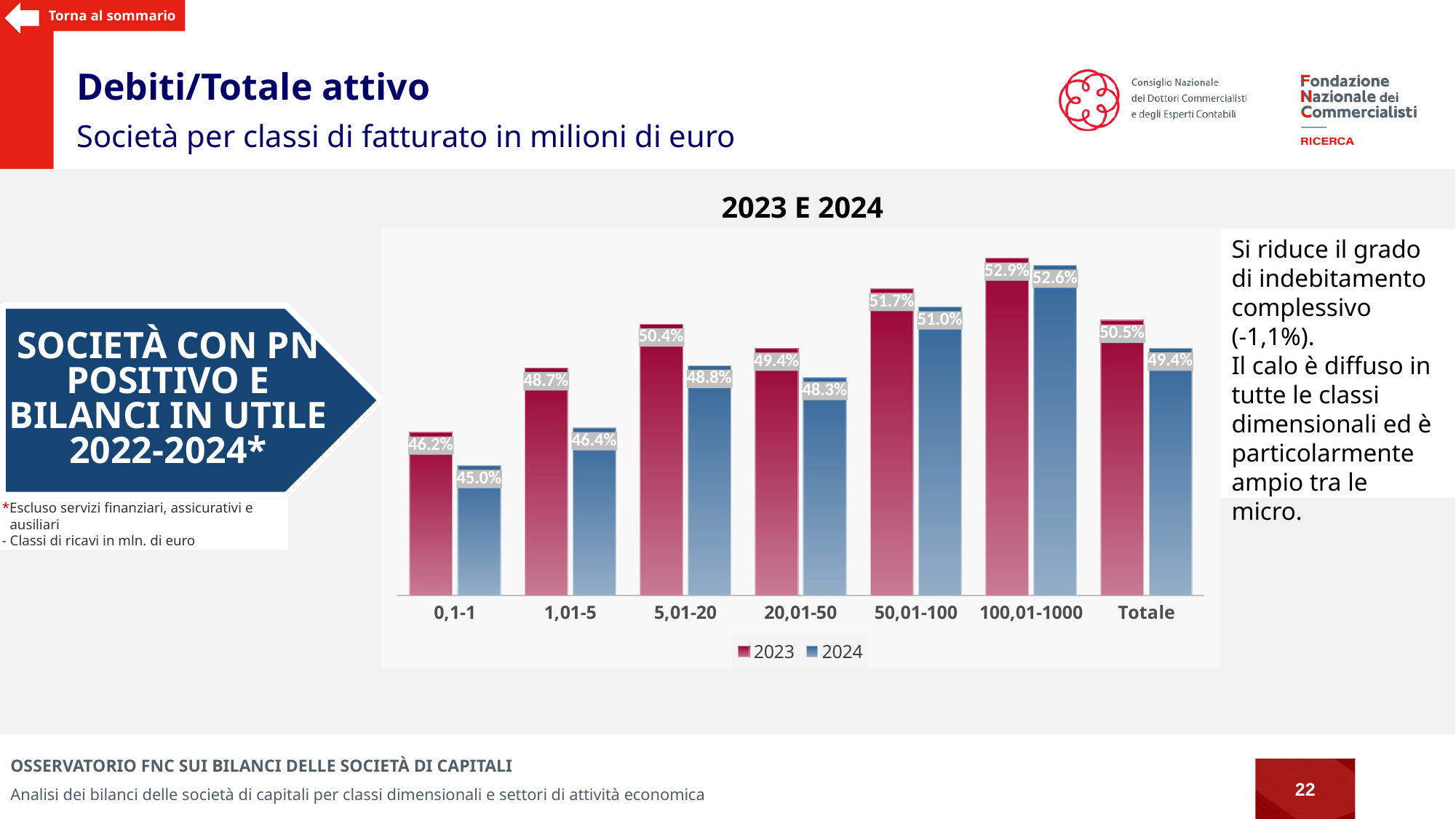
What is the difference between the 2023 and 2024 values for Totale? 1.1% How many series does the legend list? 2 Which class has the highest 2023 value? 100,01-1000 Which class has the lowest 2024 value? 0,1-1 What is the 2024 value for Totale? 49.4% What is the title of the chart? 2023 E 2024 What is the difference between the 2023 and 2024 values for the 1,01-5 class? 2.3% What is the 2023 value for the 0,1-1 class? 46.2% What is the 2024 value for the 5,01-20 class? 48.8% Which is larger, the 2023 value for 20,01-50 or the 2024 value for 50,01-100? 2024 value for 50,01-100 What kind of chart is shown? Bar chart How many revenue classes (including Totale) are shown on the x axis? 7